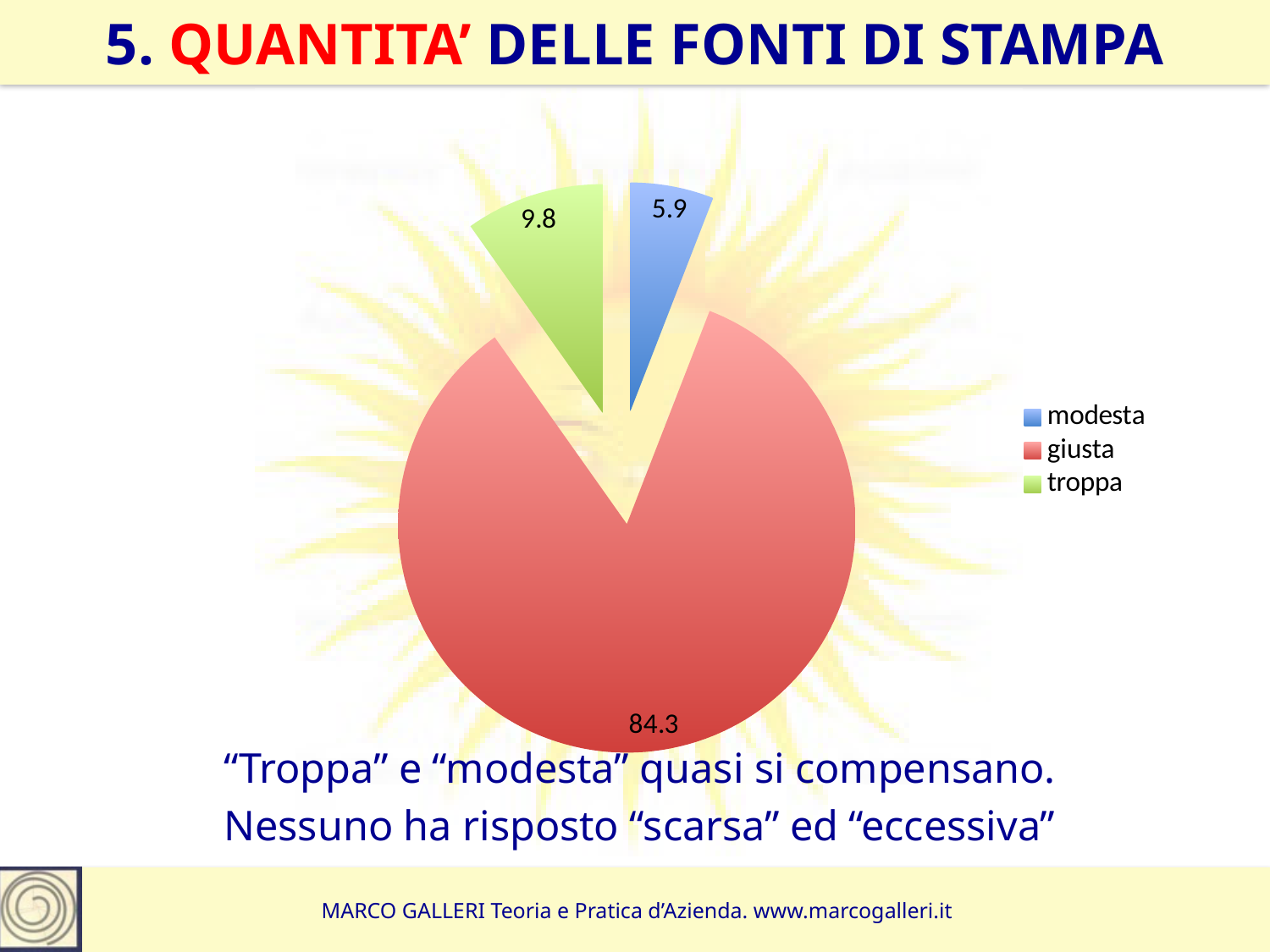
What is the value for "troppa"? 9.8 What kind of chart is shown on the slide? pie chart What is the difference between the values for "giusta" and "troppa"? 74.5 Which category has the largest slice? giusta How many entries does the legend list? 3 How many slices does the pie chart have? 3 Which category has the smallest slice? modesta What is the value for "giusta"? 84.3 What is the difference between the values for "troppa" and "modesta"? 3.9 What colour is the slice for "giusta"? red Which is larger, the value for "troppa" or the value for "modesta"? troppa What is the value for "modesta"? 5.9